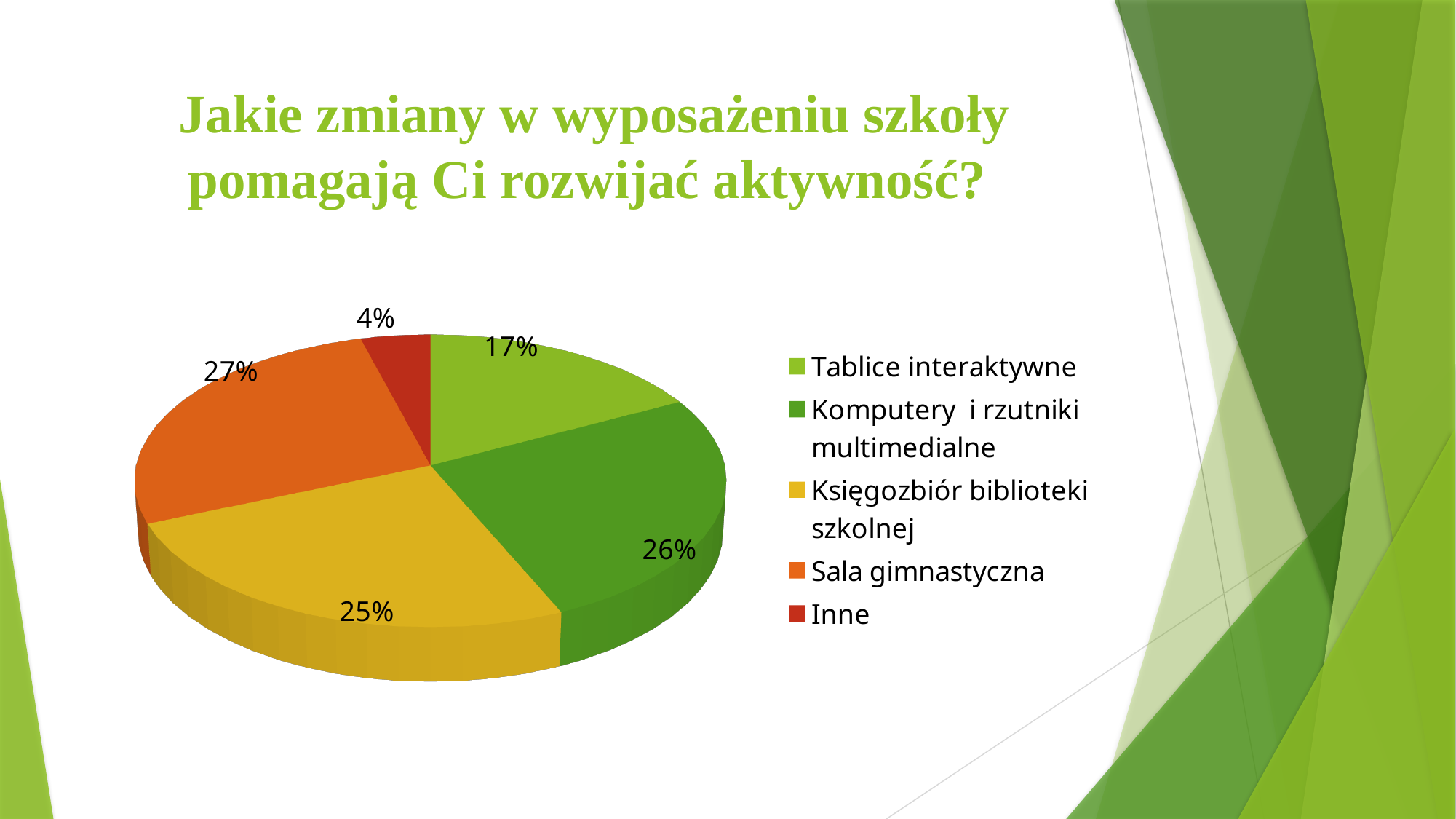
What share of the pie does Sala gimnastyczna have? 27% How many categories does the legend list? 5 Which category has the largest slice of the pie? Sala gimnastyczna What colour is the slice for Inne in the legend? dark red Which is larger: the slice for Księgozbiór biblioteki szkolnej or the slice for Inne? Księgozbiór biblioteki szkolnej What percentage of the pie is labelled for Tablice interaktywne? 17% What type of chart is shown on the slide? pie chart What is the value for Komputery i rzutniki multimedialne? 26% What percentage is shown for Inne? 4% Which category has the smallest slice of the pie? Inne What is the difference in percentage points between Sala gimnastyczna and Tablice interaktywne? 10 What is the value shown for Księgozbiór biblioteki szkolnej? 25%